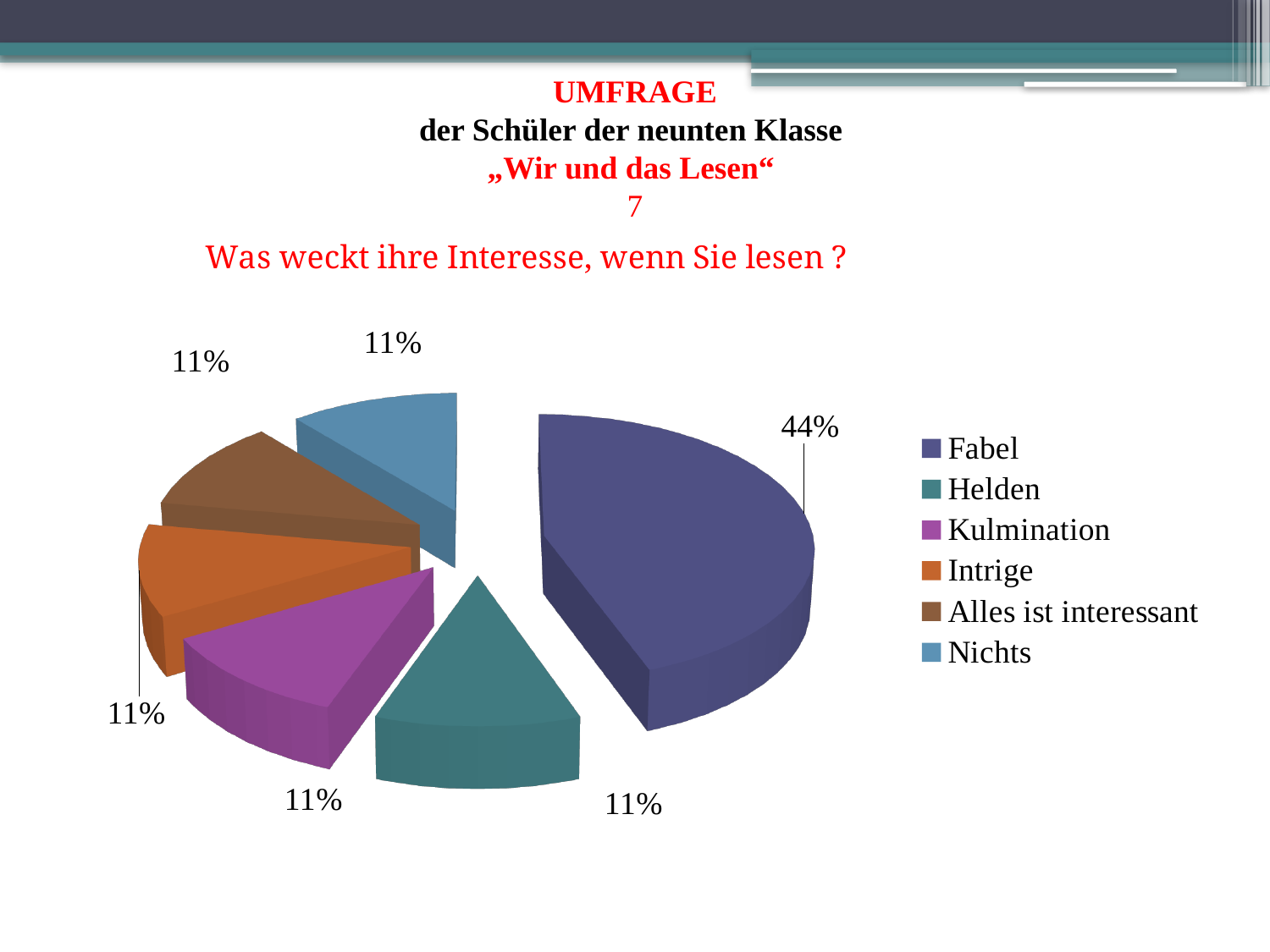
What percentage of the pie chart is labelled for Fabel? 44% What is the difference in percentage points between the Fabel slice and the Intrige slice? 33 percentage points What question is the pie chart answering, according to the red text above it? Was weckt ihre Interesse, wenn Sie lesen ? What kind of chart is shown on the slide? Pie chart What percentage does the Helden slice show? 11% Which category is listed last in the legend? Nichts Which category has the largest slice of the pie chart? Fabel What percentage is shown for the Nichts slice? 11% How many entries does the legend list? 6 How many slices does the pie chart have? 6 What share of the pie does Alles ist interessant represent? 11% Which is larger, the Fabel slice or the Kulmination slice? Fabel